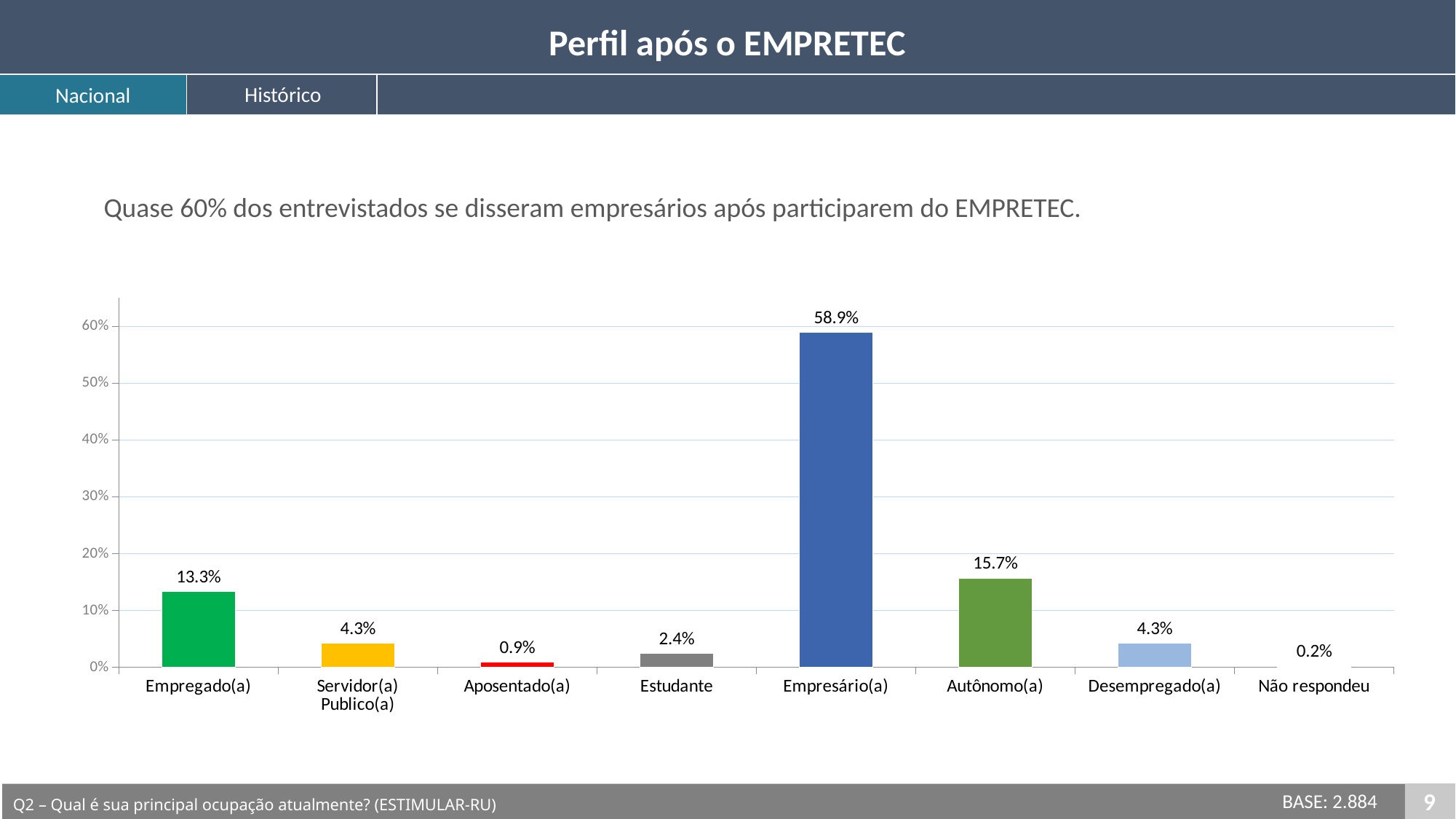
What kind of chart is shown on the slide? bar chart Which category has the highest value? Empresário(a) Is the value for Empresário(a) greater or less than 50%? greater Which is larger, the value for Empregado(a) or the value for Autônomo(a)? Autônomo(a) Which category has the lowest value? Não respondeu What is the difference between the values for Empregado(a) and Servidor(a) Publico(a)? 9.0% What is the difference between the values for Empresário(a) and Autônomo(a)? 43.2% What percentage is shown for Empresário(a)? 58.9% What is the value for Autônomo(a)? 15.7% What percentage is shown for Aposentado(a)? 0.9% What colour is the bar for Empresário(a)? blue How many categories are shown on the x axis? 8